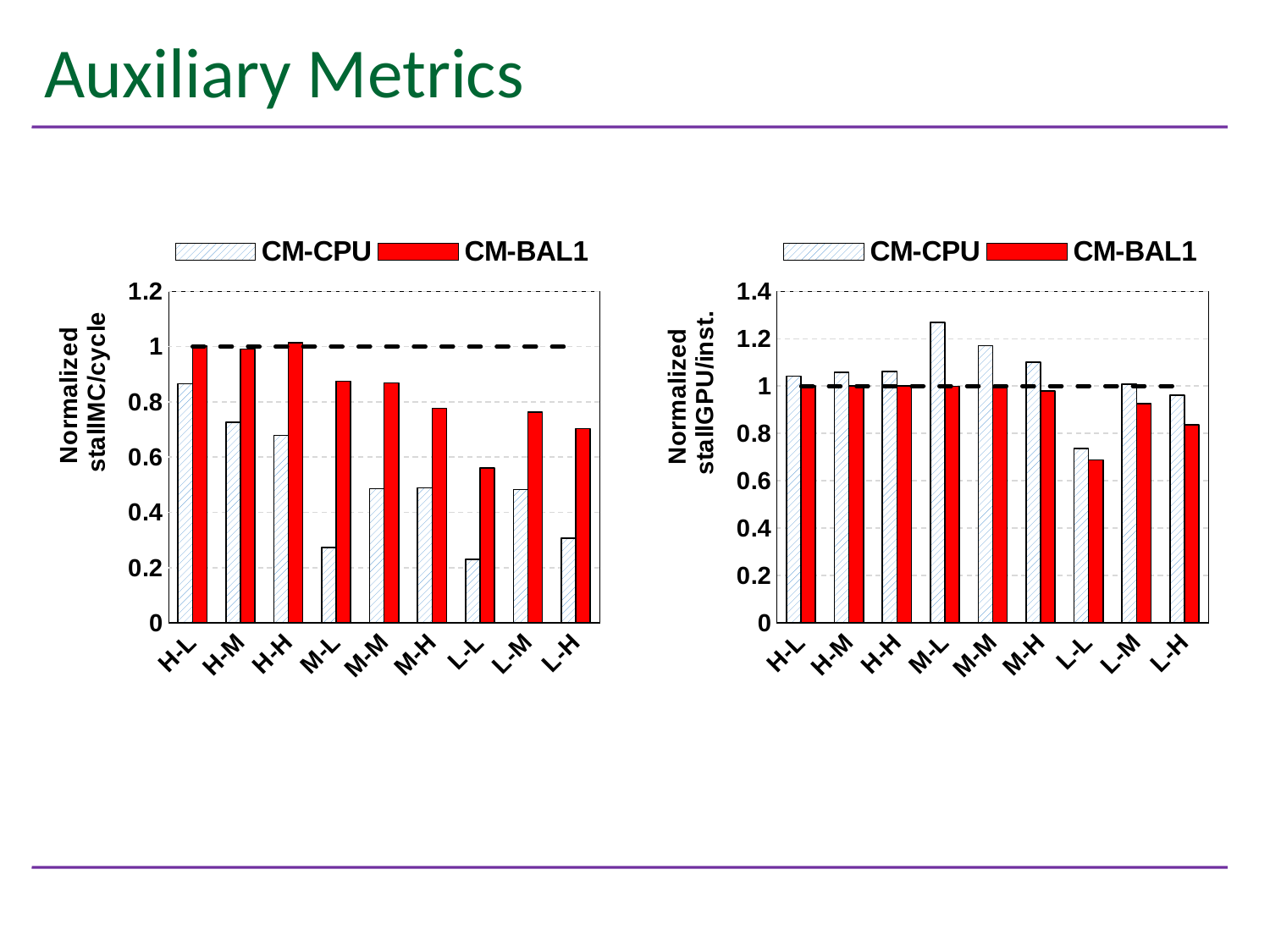
In the right chart (Normalized stallGPU/inst.), which category has the highest CM-CPU value? M-L How many series does the legend of the left chart (Normalized stallMC/cycle) list? 2 What kind of chart is the left chart (Normalized stallMC/cycle)? bar chart In the left chart (Normalized stallMC/cycle), is the CM-CPU value for M-L greater or less than 0.4? less In the right chart (Normalized stallGPU/inst.), is the CM-CPU value for M-L greater or less than 1.2? greater In the left chart (Normalized stallMC/cycle), which category has the lowest CM-CPU value? L-L In the right chart (Normalized stallGPU/inst.), is the CM-BAL1 value for L-L greater or less than 0.8? less In the left chart (Normalized stallMC/cycle), which category has the lowest CM-BAL1 value? L-L How many categories are shown on the x axis of the right chart (Normalized stallGPU/inst.)? 9 In the right chart (Normalized stallGPU/inst.), which is larger for L-H: the CM-CPU value or the CM-BAL1 value? CM-CPU What is the y-axis label of the right chart? Normalized stallGPU/inst.